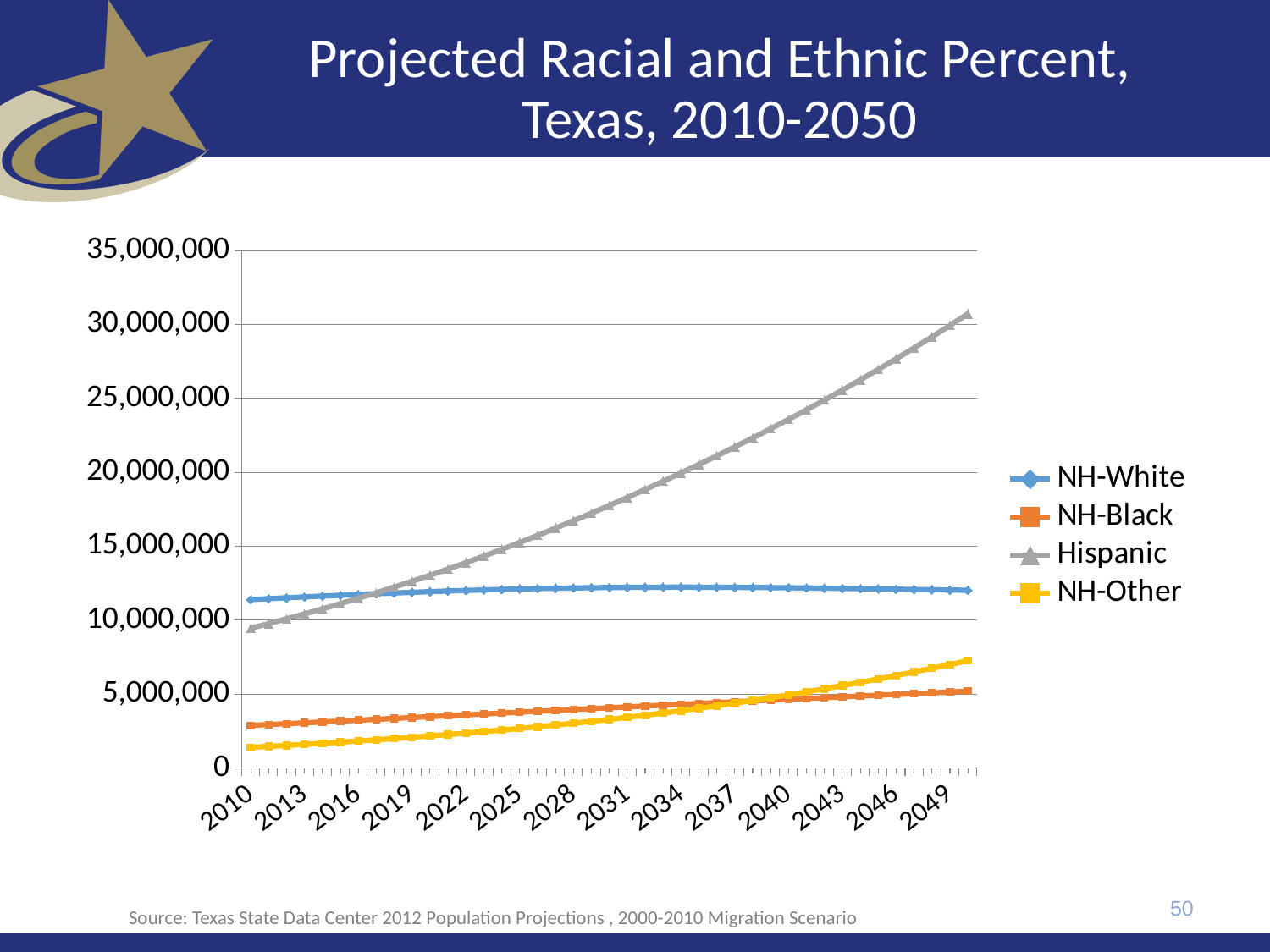
Which series has the highest value in 2049? Hispanic In 2010, which is larger, the NH-White value or the Hispanic value? NH-White Does the NH-Other series rise or fall from 2010 to 2050? rises Is the NH-White value for 2010 greater or less than 10,000,000? greater Which series has the lowest value in 2010? NH-Other What is the title of the chart on the slide? Projected Racial and Ethnic Percent, Texas, 2010-2050 Is the Hispanic value for 2040 greater or less than 20,000,000? greater Is the NH-Black value for 2010 greater or less than 5,000,000? less How many series does the legend list? 4 Does the Hispanic series rise or fall from 2010 to 2050? rises What kind of chart is shown on the slide? line chart In 2049, which is larger, the NH-Other value or the NH-Black value? NH-Other